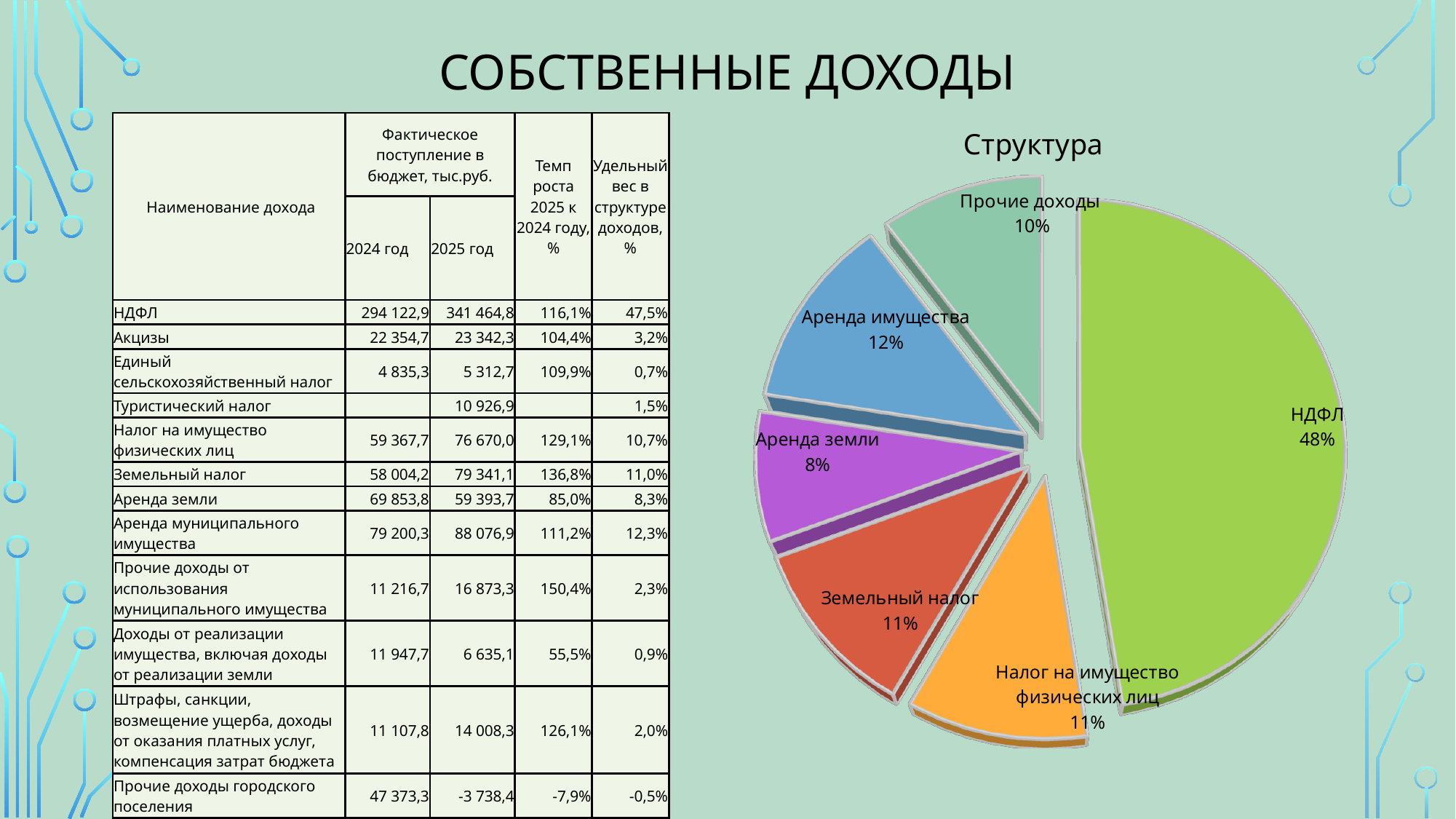
In the "Структура" pie chart, what share does Аренда земли have? 8% In the "Структура" pie chart, what share does Земельный налог have? 11% What kind of chart is shown under the title "Структура"? pie chart In the "Структура" pie chart, what share does НДФЛ have? 48% What is the title of the pie chart on the slide? Структура Which slice is the smallest in the "Структура" pie chart? Аренда земли In the "Структура" pie chart, what is the difference in percentage points between НДФЛ and Аренда имущества? 36 In the "Структура" pie chart, what share does Прочие доходы have? 10% In the "Структура" pie chart, which is larger: Аренда имущества or Прочие доходы? Аренда имущества How many slices does the "Структура" pie chart have? 6 Which slice is the largest in the "Структура" pie chart? НДФЛ In the "Структура" pie chart, what share does Аренда имущества have? 12%